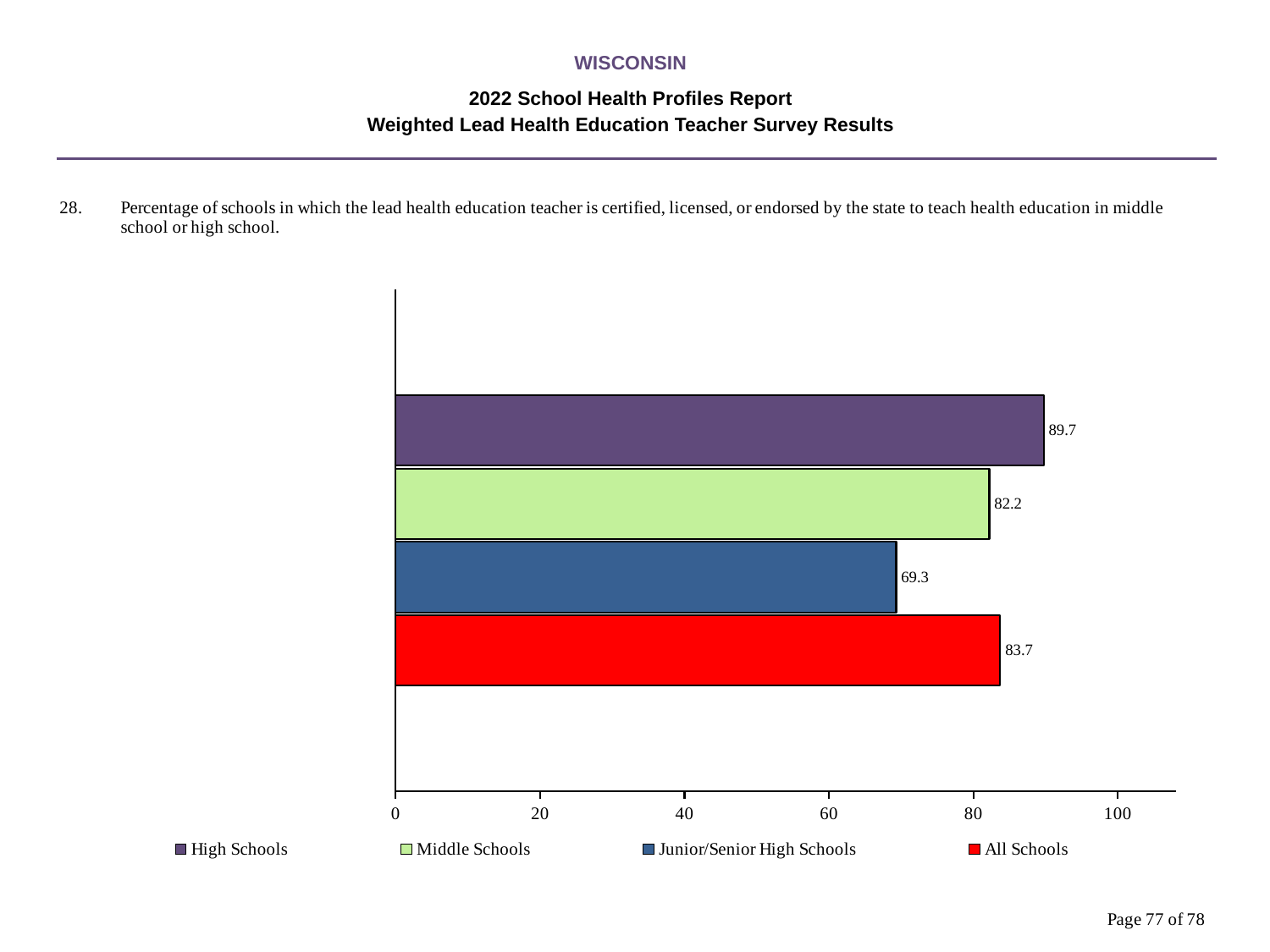
Which school type has the lowest value? Junior/Senior High Schools What is the difference between the All Schools value and the Middle Schools value? 1.5 What is the value for All Schools? 83.7 What is the value for Middle Schools? 82.2 Is the value for Junior/Senior High Schools greater or less than 80? less What is the value for High Schools? 89.7 How many series does the legend list? 4 What is the value for Junior/Senior High Schools? 69.3 Which school type has the highest value? High Schools What kind of chart is shown on the slide? bar chart What is the difference between the High Schools value and the Junior/Senior High Schools value? 20.4 Which is larger, the value for High Schools or the value for Middle Schools? High Schools